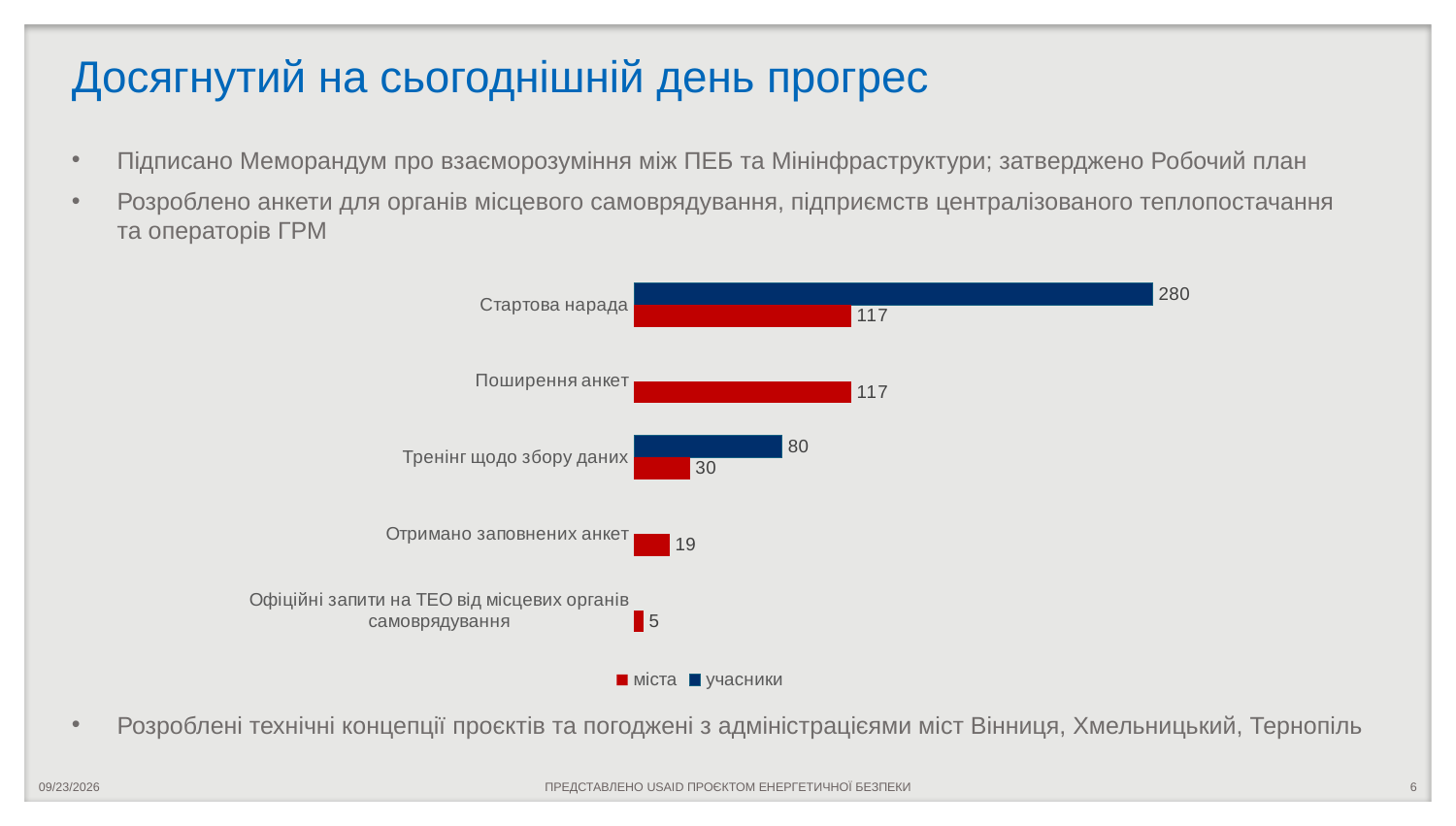
How many categories are shown on the chart? 5 What kind of chart is shown on the slide? bar chart What is the value of міста for Поширення анкет? 117 Which is larger: учасники for Стартова нарада or учасники for Тренінг щодо збору даних? учасники for Стартова нарада Which colour represents the series міста in the chart? red What is the value of міста for Стартова нарада? 117 What is the value of міста for Отримано заповнених анкет? 19 How many series does the chart legend list? 2 What is the difference between учасники and міста for Тренінг щодо збору даних? 50 What is the value of учасники for Тренінг щодо збору даних? 80 What is the value of учасники for Стартова нарада? 280 Which category has the lowest value for міста? Офіційні запити на ТЕО від місцевих органів самоврядування